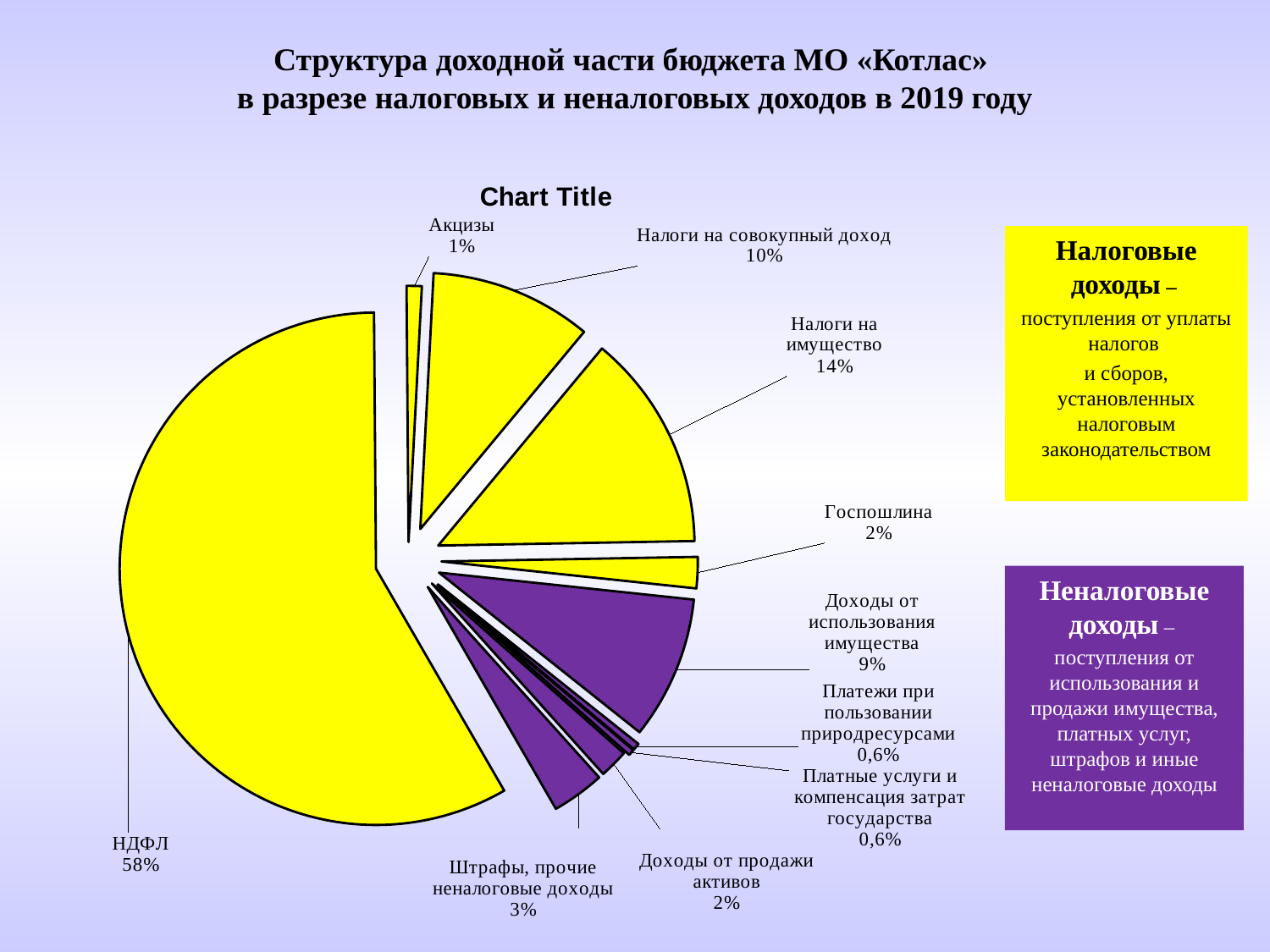
What is the value shown for Платежи при пользовании природресурсами? 0,6% What type of chart is shown on the slide? pie chart What is the difference between the shares of НДФЛ and Налоги на имущество? 44% Which category has the largest slice of the pie? НДФЛ What is the value shown for Налоги на имущество? 14% What colour are the slices representing non-tax revenues (неналоговые доходы)? purple What is the value shown for Штрафы, прочие неналоговые доходы? 3% What share of the pie does НДФЛ account for? 58% What is the value shown for Доходы от использования имущества? 9% What is the title printed above the pie chart? Chart Title How many slices does the pie chart have? 10 Which is larger, Налоги на совокупный доход or Налоги на имущество? Налоги на имущество